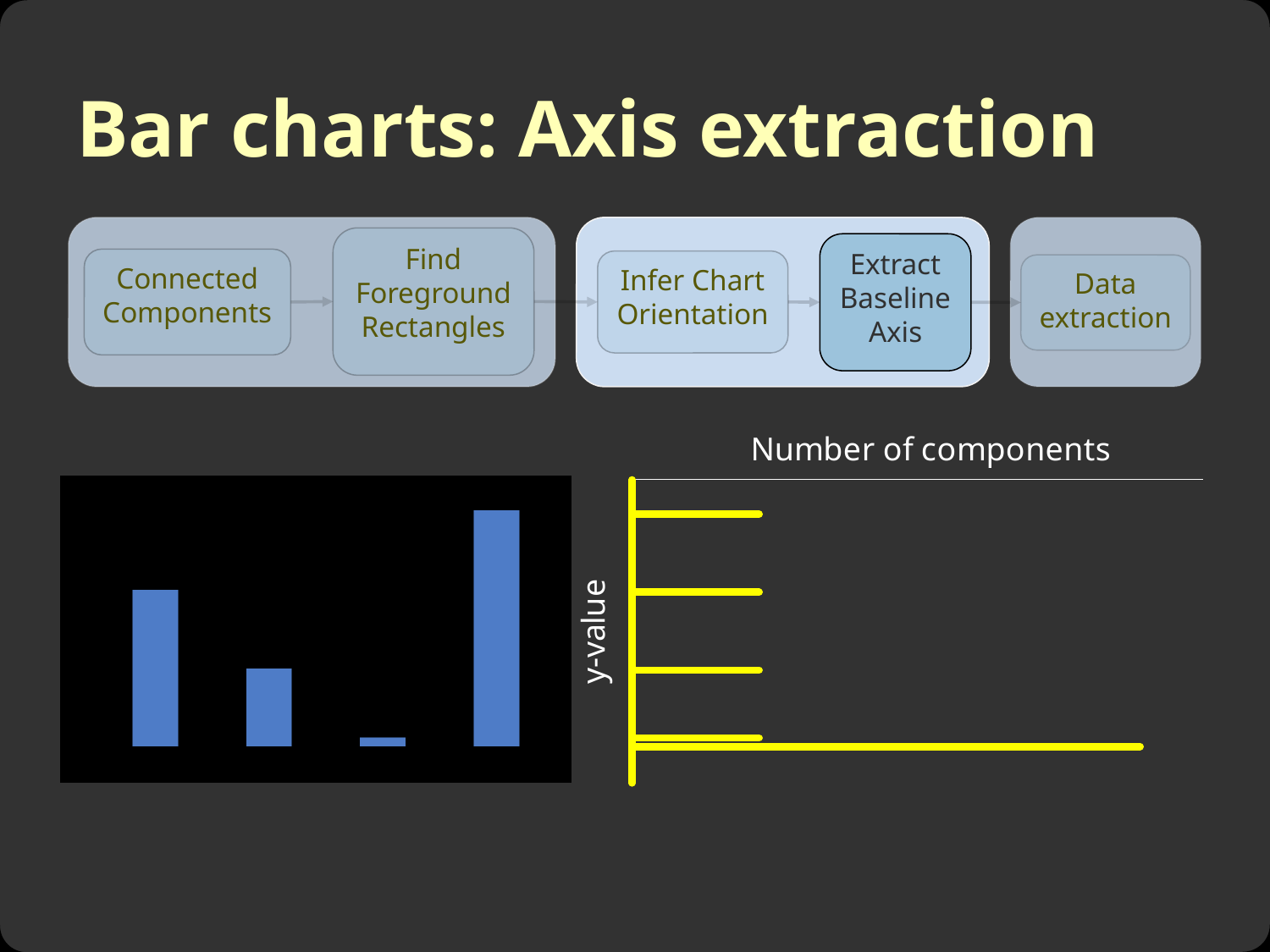
What is the vertical axis label of the yellow-line plot on the right side of the slide? y-value In the bar chart on the left side of the slide, is the first bar taller or shorter than the second bar? taller What kind of chart is shown on the left side of the slide, on the black background? bar chart In the bar chart on the left side of the slide, is the second bar taller or shorter than the fourth bar? shorter In the bar chart on the left side of the slide, which bar is the shortest, counting from the left? the third bar How many horizontal yellow lines extend from the vertical axis in the plot on the right side of the slide? 5 In the bar chart on the left side of the slide, do the bar heights rise steadily, fall steadily, or neither from left to right? neither What is the title shown above the yellow-line plot on the right side of the slide? Number of components How many bars are in the bar chart on the left side of the slide? 4 In the yellow-line plot on the right side of the slide, which horizontal line is the longest? the lowest (bottom) line What colour are the bars in the bar chart on the left side of the slide? blue In the bar chart on the left side of the slide, which bar is the tallest, counting from the left? the fourth (rightmost) bar